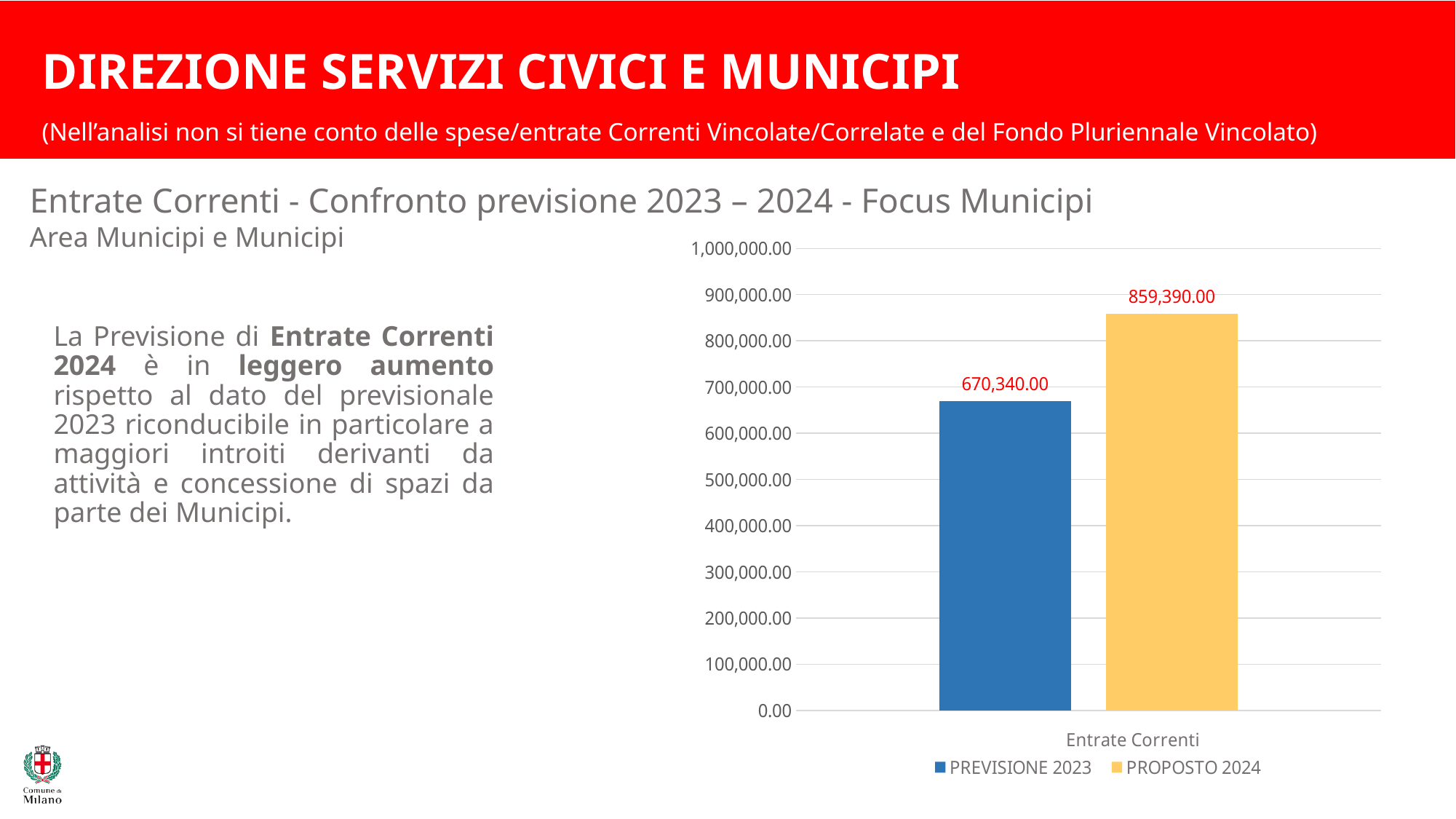
Is the value for PREVISIONE 2023 greater or less than 700,000.00? less How many series does the legend list? 2 Is the value for PROPOSTO 2024 greater or less than 800,000.00? greater What kind of chart is shown on the slide? Bar chart What is the difference between the PROPOSTO 2024 value and the PREVISIONE 2023 value? 189,050.00 Which series has the higher value, PREVISIONE 2023 or PROPOSTO 2024? PROPOSTO 2024 Which series has the lowest value in the chart? PREVISIONE 2023 What is the value for PREVISIONE 2023 in the Entrate Correnti chart? 670,340.00 What is the value for PROPOSTO 2024 in the Entrate Correnti chart? 859,390.00 What colour is the bar for PROPOSTO 2024? Yellow What is the highest value shown on the y axis of the chart? 1,000,000.00 What is the category label shown on the x axis of the chart? Entrate Correnti